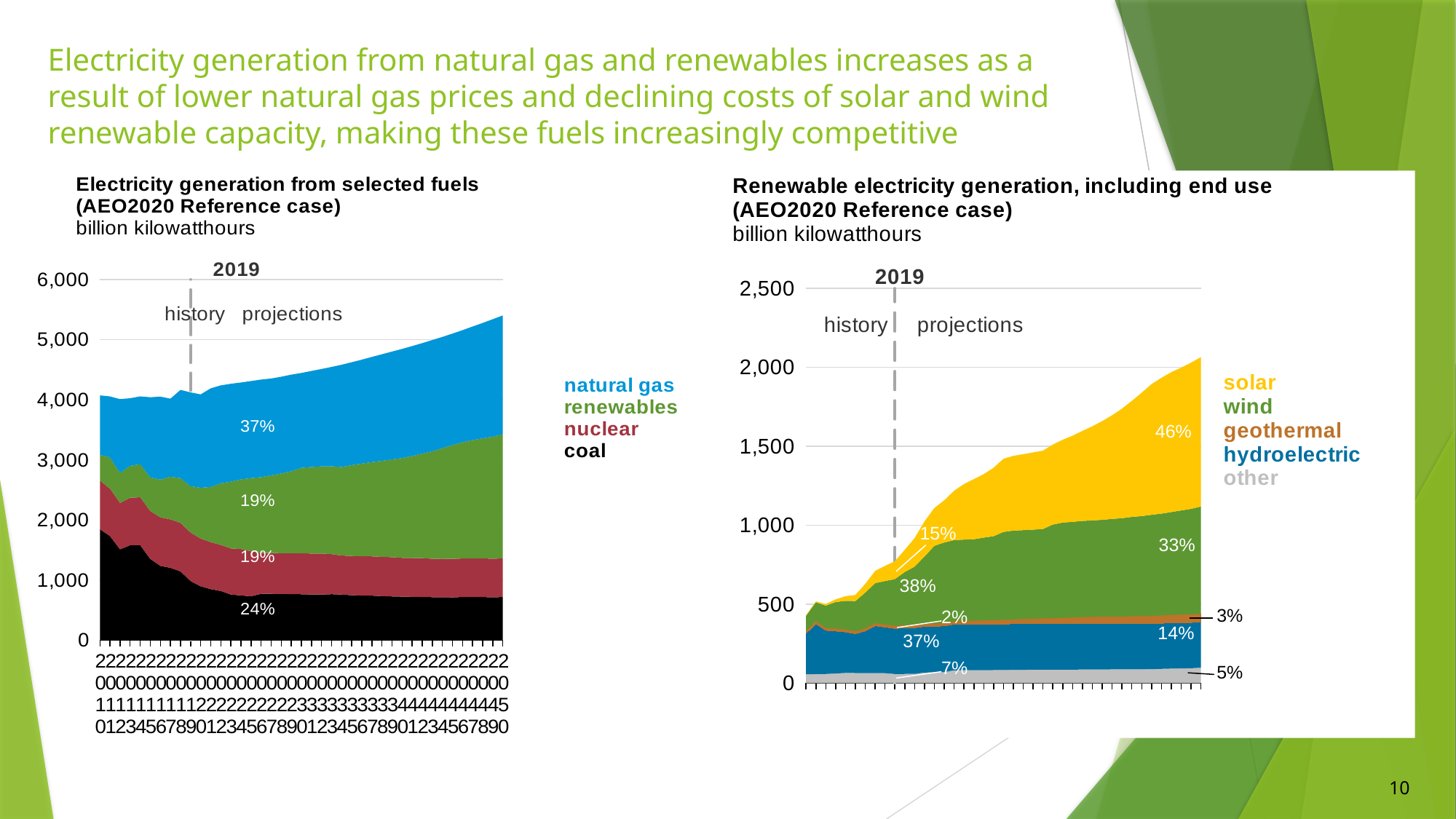
In the left chart, 'Electricity generation from selected fuels', is the total generation at the end of the projection period greater or less than 5,000 billion kilowatthours? greater In the left chart, 'Electricity generation from selected fuels', what share label is shown on the natural gas area? 37% In the right chart, 'Renewable electricity generation, including end use', what share label is shown for solar at the end of the projection period? 46% In the right chart, 'Renewable electricity generation, including end use', does total renewable generation rise or fall over the projection period? rise In the right chart, 'Renewable electricity generation, including end use', what share label is shown for hydroelectric at the end of the projection period? 14% How many series does the legend of the right chart, 'Renewable electricity generation, including end use', list? 5 What unit is stated under the title of the left chart, 'Electricity generation from selected fuels'? billion kilowatthours How many series does the legend of the left chart, 'Electricity generation from selected fuels', list? 4 What kind of chart is the 'Electricity generation from selected fuels' chart on the left? stacked area chart In the right chart, 'Renewable electricity generation, including end use', what share label is shown for wind at the 2019 line? 38% In the left chart, 'Electricity generation from selected fuels', what share label is shown on the coal area? 24% In the right chart, 'Renewable electricity generation, including end use', what is the difference between the solar share at the end of the projections (46%) and the solar share at 2019 (15%)? 31%